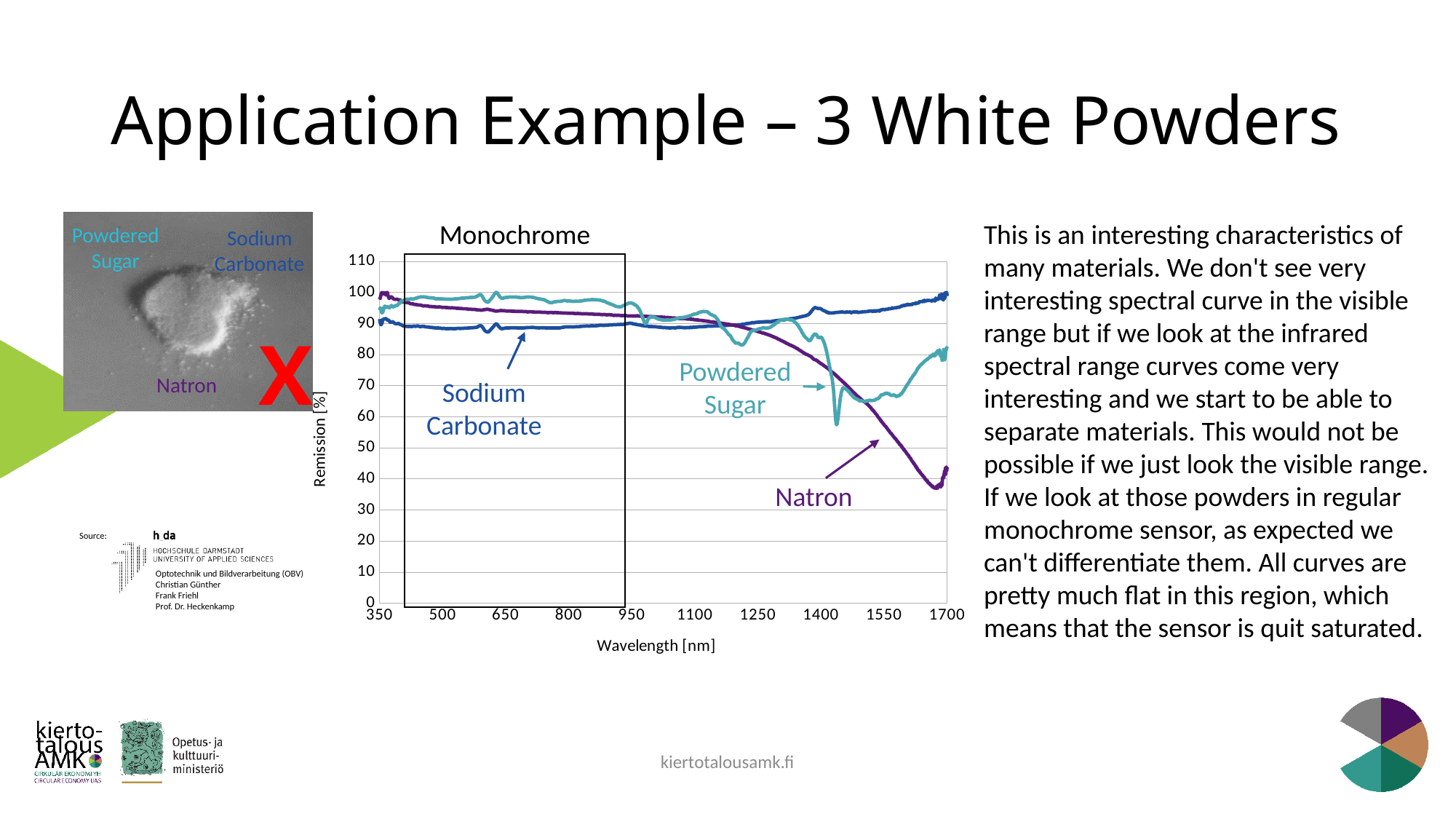
Which series has the lowest remission at 1700 nm? Natron At 1400 nm, which has the larger remission: Sodium Carbonate or Natron? Sodium Carbonate Is the lowest remission value of Powdered Sugar greater or less than 70? less What is the label of the x axis? Wavelength [nm] How many series (materials) are plotted on the chart? 3 What kind of chart is shown on the slide? line chart Which series has the highest remission at 1700 nm? Sodium Carbonate Is the remission of Natron at 1550 nm greater or less than 70? less Does the Natron curve rise or fall overall as wavelength increases from 950 nm to 1700 nm? fall Is the remission of Natron at 1700 nm greater or less than 50? less What label is written above the boxed region on the left of the chart? Monochrome Which series has the lowest remission at 650 nm? Sodium Carbonate